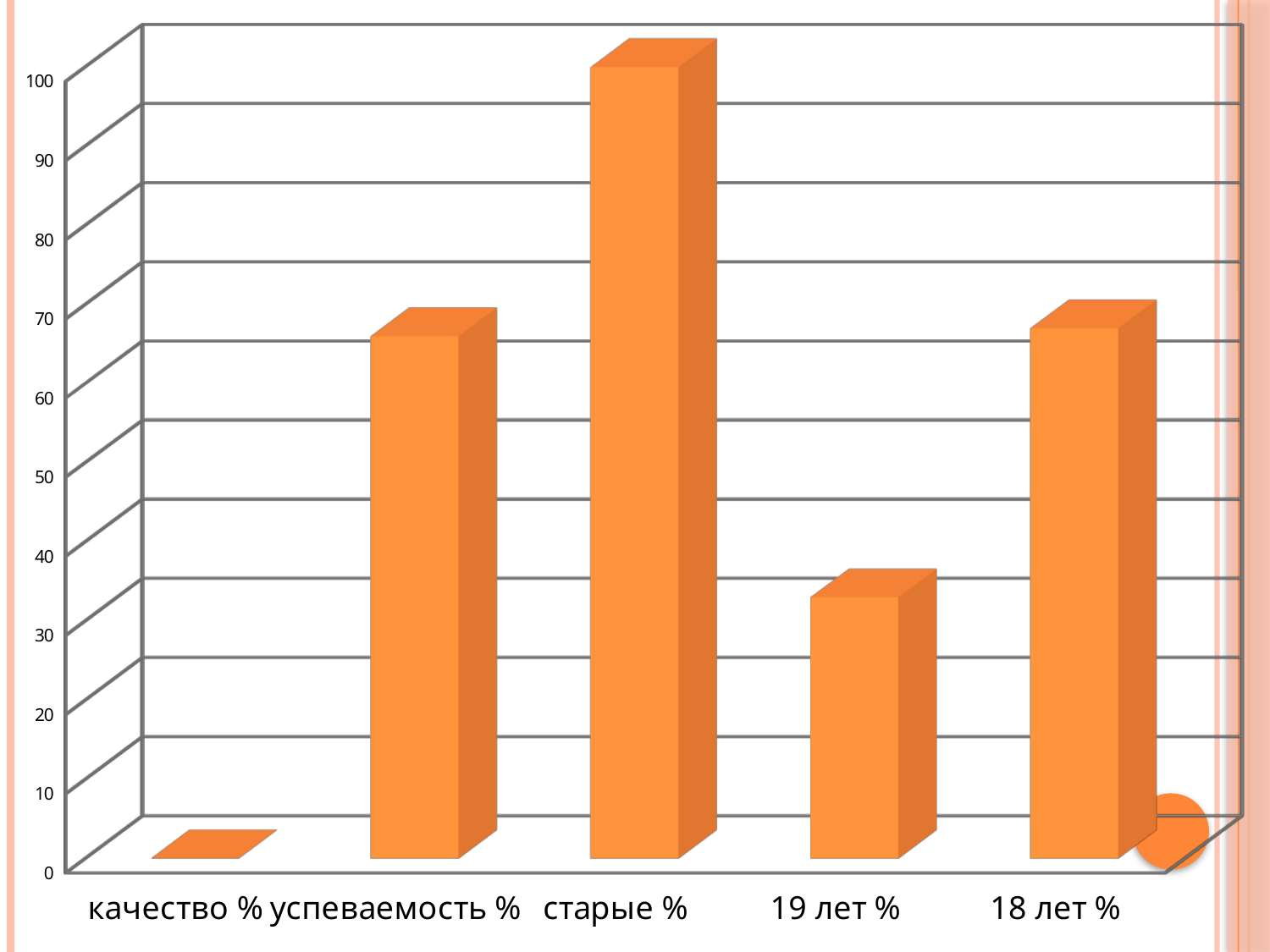
Which is larger, the value for старые % or the value for 19 лет %? старые % Which is larger, the value for успеваемость % or the value for 19 лет %? успеваемость % Is the value for 19 лет % greater or less than 40? less What kind of chart is shown on the slide? bar chart Is the value for 18 лет % greater or less than 60? greater Which category has the highest bar? старые % Is the value for успеваемость % greater or less than 50? greater What colour are the bars in the chart? orange Which category has the lowest bar? качество % How many categories are shown on the x axis of the chart? 5